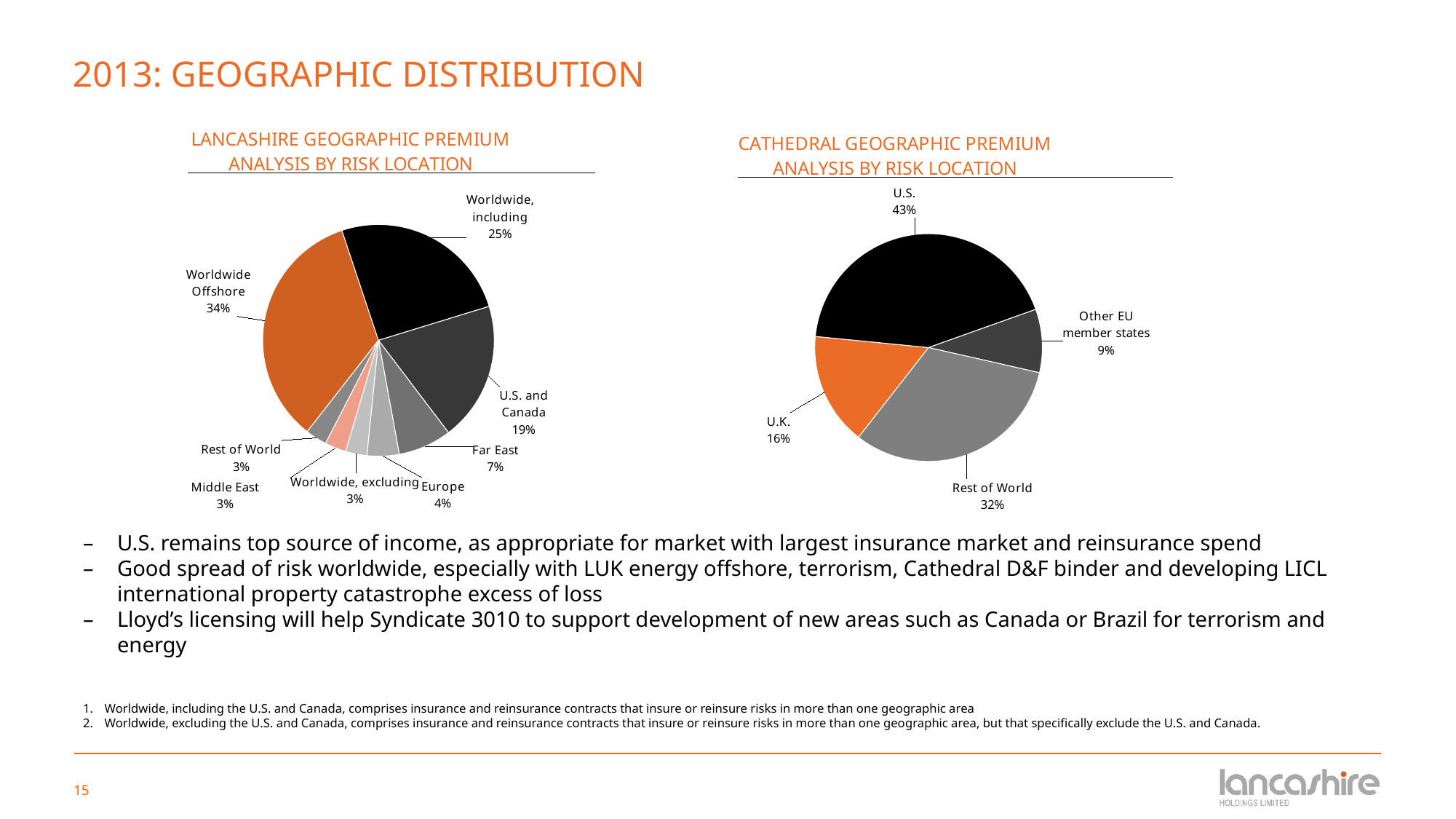
In the Lancashire Geographic Premium Analysis by Risk Location chart, which category has the largest share? Worldwide Offshore In the Lancashire Geographic Premium Analysis by Risk Location chart, what share does U.S. and Canada have? 19% In the Lancashire Geographic Premium Analysis by Risk Location chart, what is the difference between the Worldwide Offshore share and the Far East share? 27% In the Cathedral Geographic Premium Analysis by Risk Location chart, what share does the U.K. have? 16% In the Cathedral Geographic Premium Analysis by Risk Location chart, what is the difference between the U.S. share and the Rest of World share? 11% In the Cathedral Geographic Premium Analysis by Risk Location chart, what share does the U.S. have? 43% In the Cathedral Geographic Premium Analysis by Risk Location chart, which category has the smallest share? Other EU member states In the Lancashire Geographic Premium Analysis by Risk Location chart, what share does Worldwide Offshore have? 34% In the Lancashire Geographic Premium Analysis by Risk Location chart, how many slices does the pie have? 8 What type of chart is the Cathedral Geographic Premium Analysis by Risk Location chart? Pie chart In the Cathedral Geographic Premium Analysis by Risk Location chart, how many categories are shown? 4 In the Lancashire Geographic Premium Analysis by Risk Location chart, which is larger, Far East or Europe? Far East